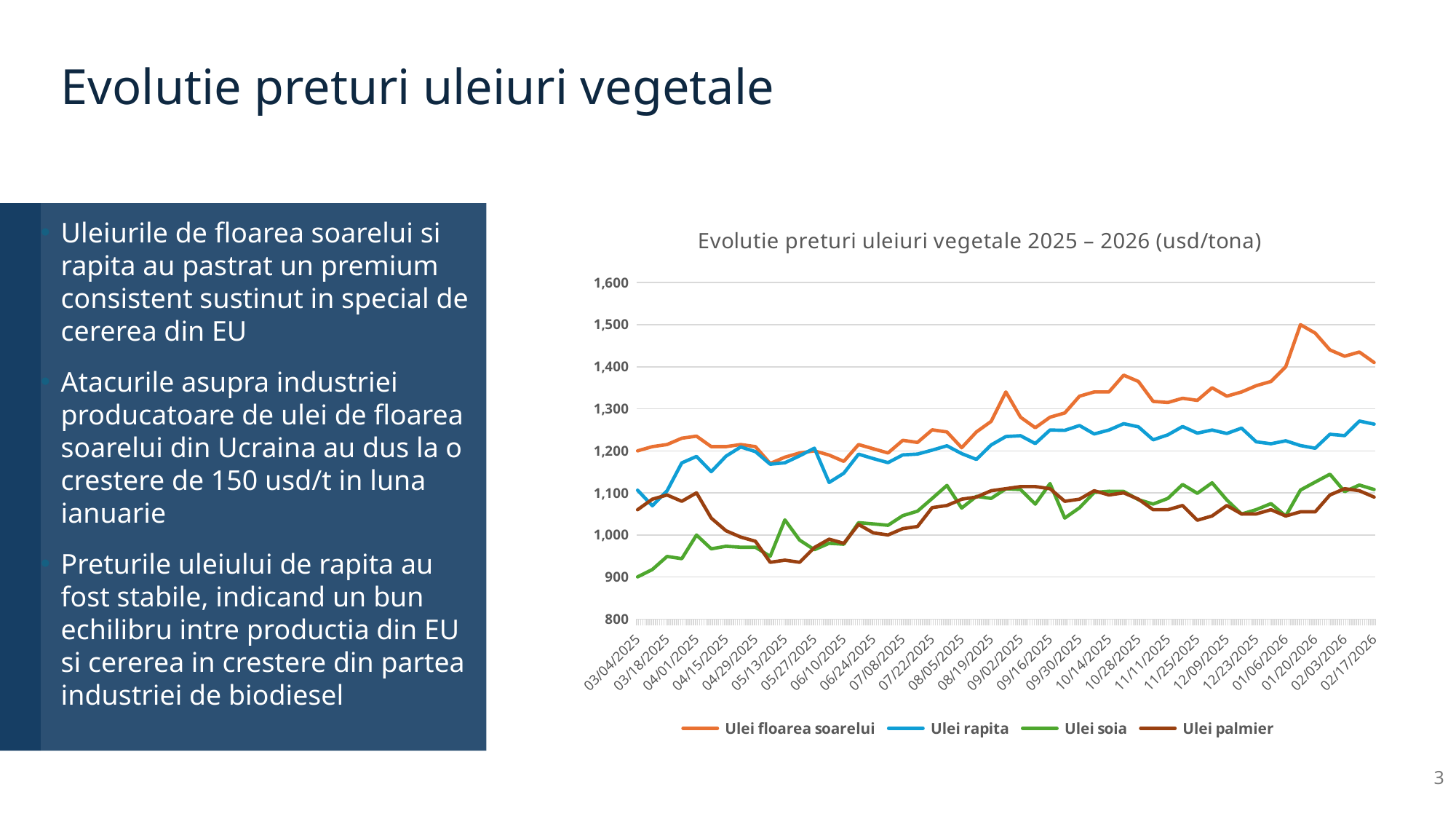
Is the value for Ulei rapita on 03/04/2025 greater or less than 1,200? less Which series has the highest value on 02/17/2026? Ulei floarea soarelui Which series has the lowest value on 03/04/2025? Ulei soia Is the value for Ulei soia on 03/04/2025 greater or less than 1,000? less Which colour is used for the Ulei rapita series? Blue On 03/04/2025, which is higher: Ulei rapita or Ulei soia? Ulei rapita What kind of chart is shown on the slide? Line chart Does the Ulei floarea soarelui series rise or fall overall from 03/04/2025 to 02/17/2026? Rise How many series does the chart legend list? 4 Is the value for Ulei floarea soarelui on 01/20/2026 greater or less than 1,400? greater What is the title of the chart? Evolutie preturi uleiuri vegetale 2025 – 2026 (usd/tona)